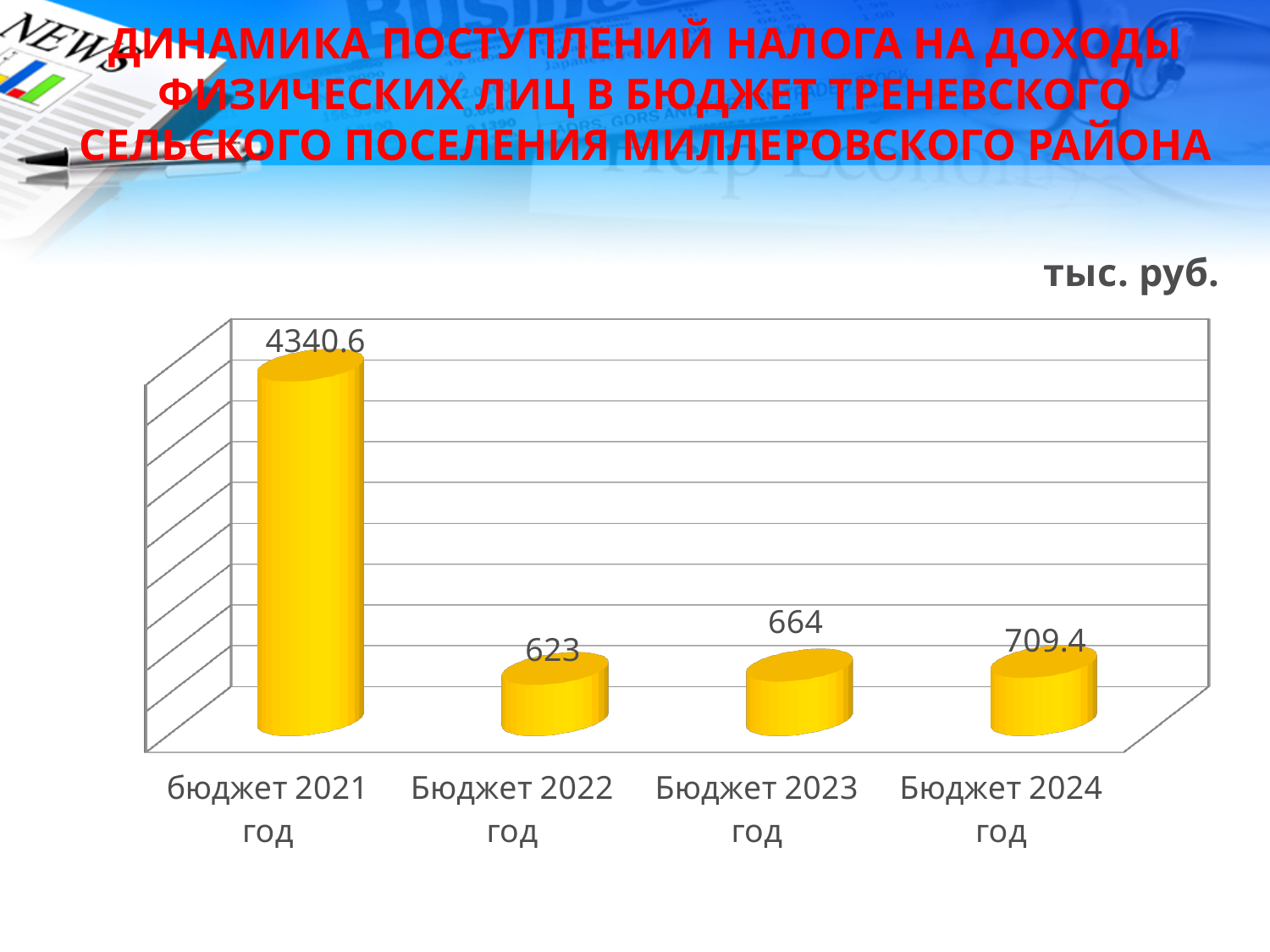
How many categories are shown on the chart? 4 Which is larger, the value for Бюджет 2023 год or Бюджет 2022 год? Бюджет 2023 год What is the difference between the values for бюджет 2021 год and Бюджет 2022 год? 3717.6 Which category has the lowest value? Бюджет 2022 год What unit is indicated above the chart? тыс. руб. What kind of chart is shown on the slide? bar chart What is the value for Бюджет 2022 год? 623 Which category has the highest value? бюджет 2021 год What is the value for бюджет 2021 год? 4340.6 What is the difference between the values for Бюджет 2024 год and Бюджет 2023 год? 45.4 What is the value for Бюджет 2023 год? 664 What is the value for Бюджет 2024 год? 709.4